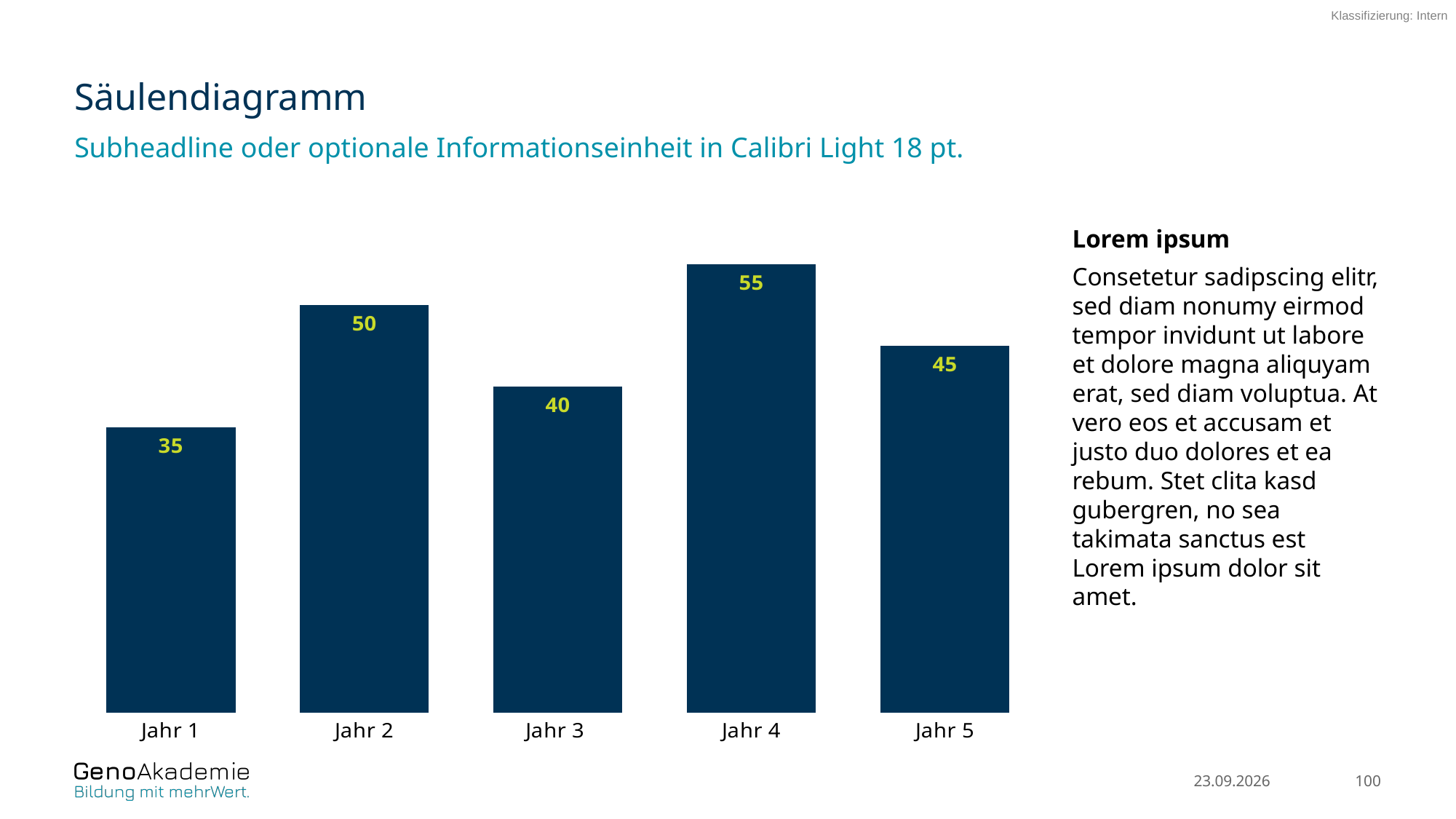
Which year has the highest value? Jahr 4 What is the title of the slide containing the chart? Säulendiagramm What is the value for Jahr 1? 35 Which is larger, the value for Jahr 2 or the value for Jahr 5? Jahr 2 What kind of chart is shown on the slide? Bar chart How many years are shown on the chart? 5 What is the value for Jahr 3? 40 What is the difference between the values for Jahr 4 and Jahr 1? 20 Does the value rise or fall from Jahr 2 to Jahr 3? Fall What is the difference between the values for Jahr 2 and Jahr 3? 10 Which year has the lowest value? Jahr 1 What is the value for Jahr 5? 45